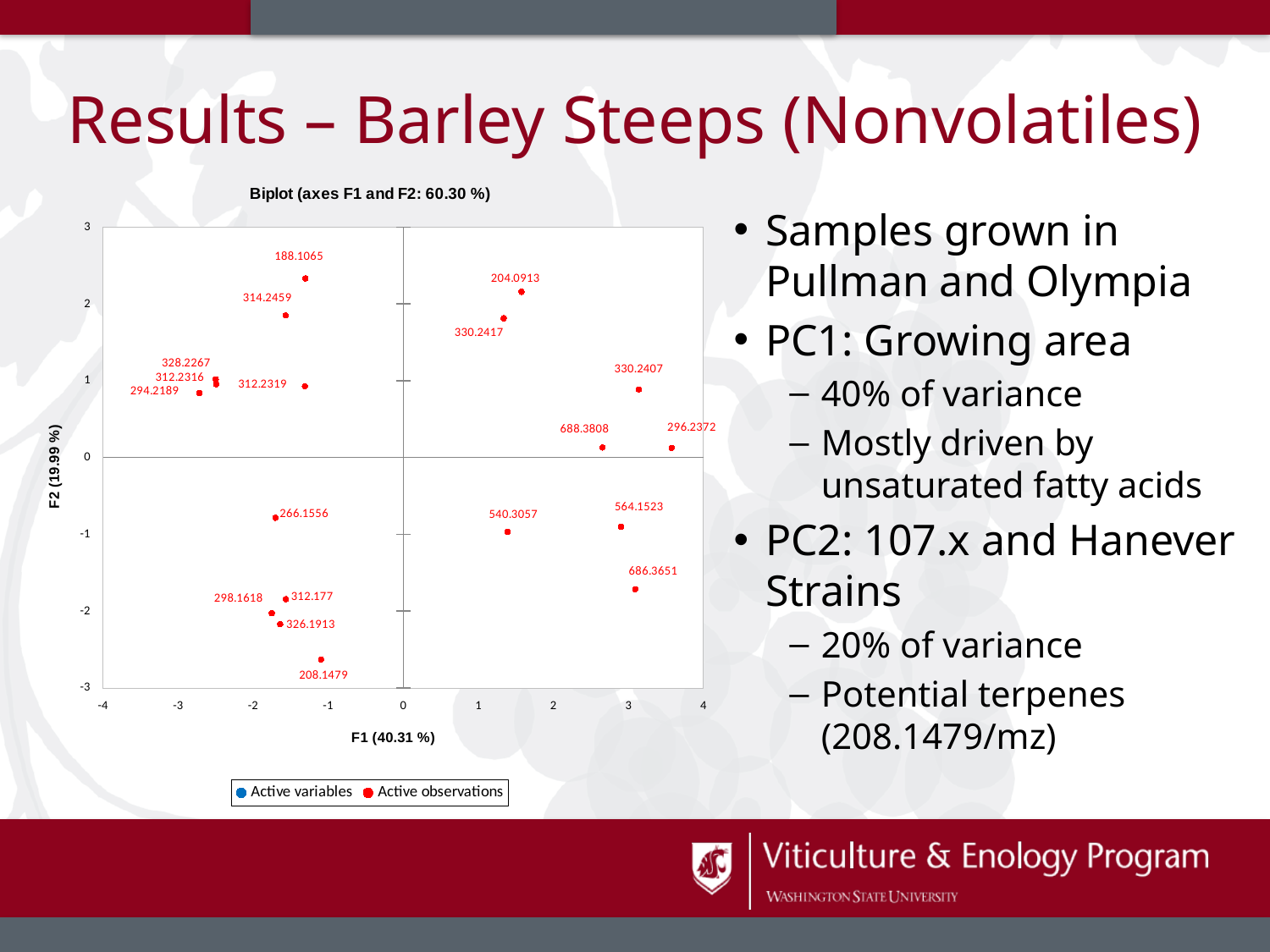
Which labelled point has the lowest F1 value on the chart? 294.2189 Which point has a higher F2 value, 204.0913 or 540.3057? 204.0913 What kind of chart is shown on the slide? Scatter plot Which labelled point has the highest F1 value on the chart? 296.2372 What is the title of the chart? Biplot (axes F1 and F2: 60.30 %) What is the label of the horizontal axis of the chart? F1 (40.31 %) Which labelled point has the lowest F2 value on the chart? 208.1479 Is the F2 value for point 188.1065 greater or less than 2? greater Is the F1 value for point 296.2372 greater or less than 3? greater How many entries does the chart legend list? 2 Is the F2 value for point 208.1479 greater or less than -2? less How many labelled points are plotted on the chart? 19